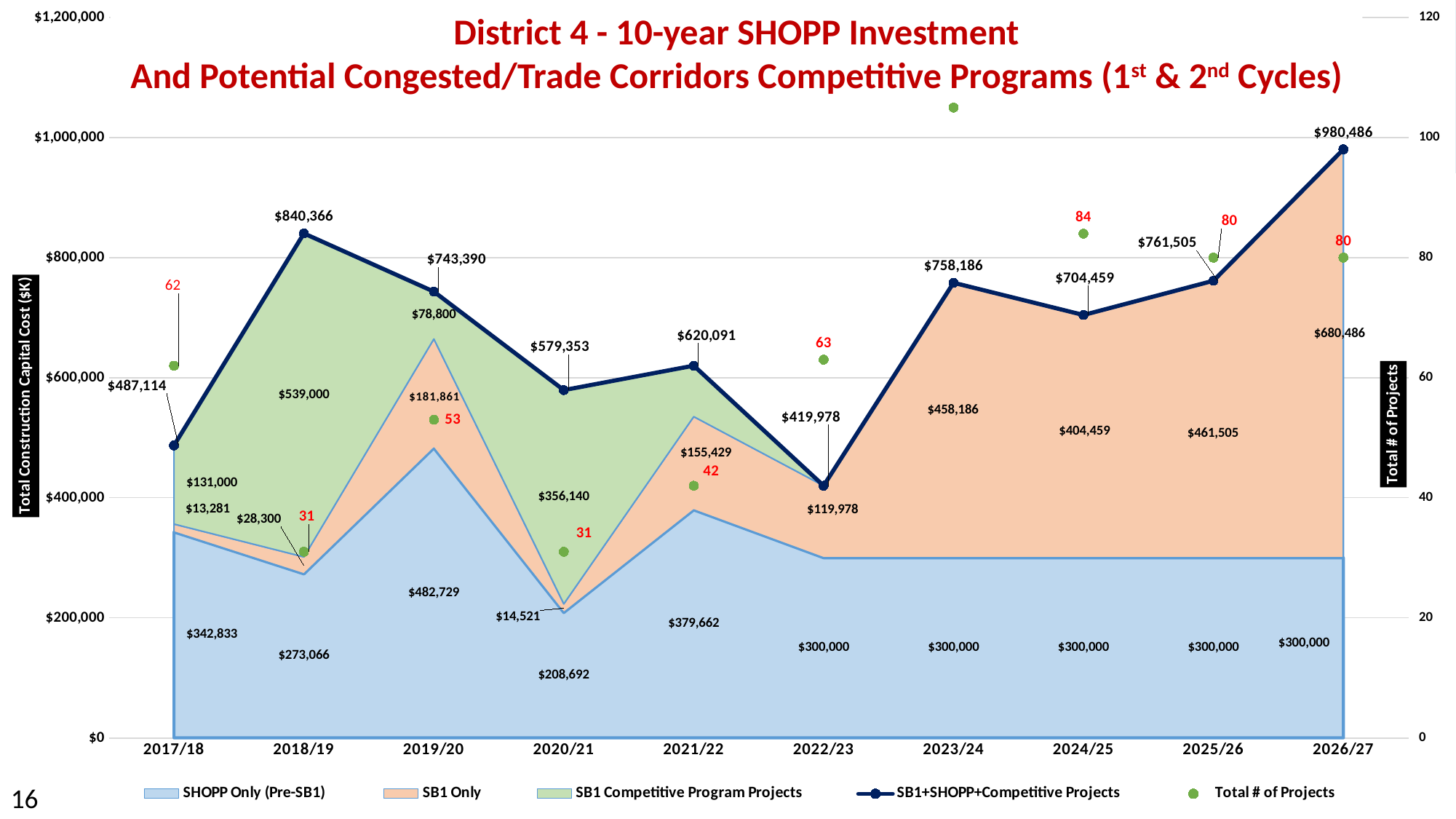
How many fiscal years are shown on the x axis? 10 Which fiscal year has the highest SB1+SHOPP+Competitive Projects total? 2026/27 Which is larger, the SB1+SHOPP+Competitive Projects total for 2019/20 or for 2020/21? 2019/20 What is the SHOPP Only (Pre-SB1) value for 2019/20? $482,729 What is the SB1 Only value for 2023/24? $458,186 What is the difference between the SB1+SHOPP+Competitive Projects totals for 2018/19 and 2017/18? $353,252 Which fiscal year has the lowest SB1+SHOPP+Competitive Projects total? 2022/23 What is the Total # of Projects for 2024/25? 84 Is the Total # of Projects for 2023/24 greater or less than 100? greater How many series does the legend list? 5 What is the SB1 Competitive Program Projects value for 2018/19? $539,000 What is the SB1+SHOPP+Competitive Projects total for 2026/27? $980,486